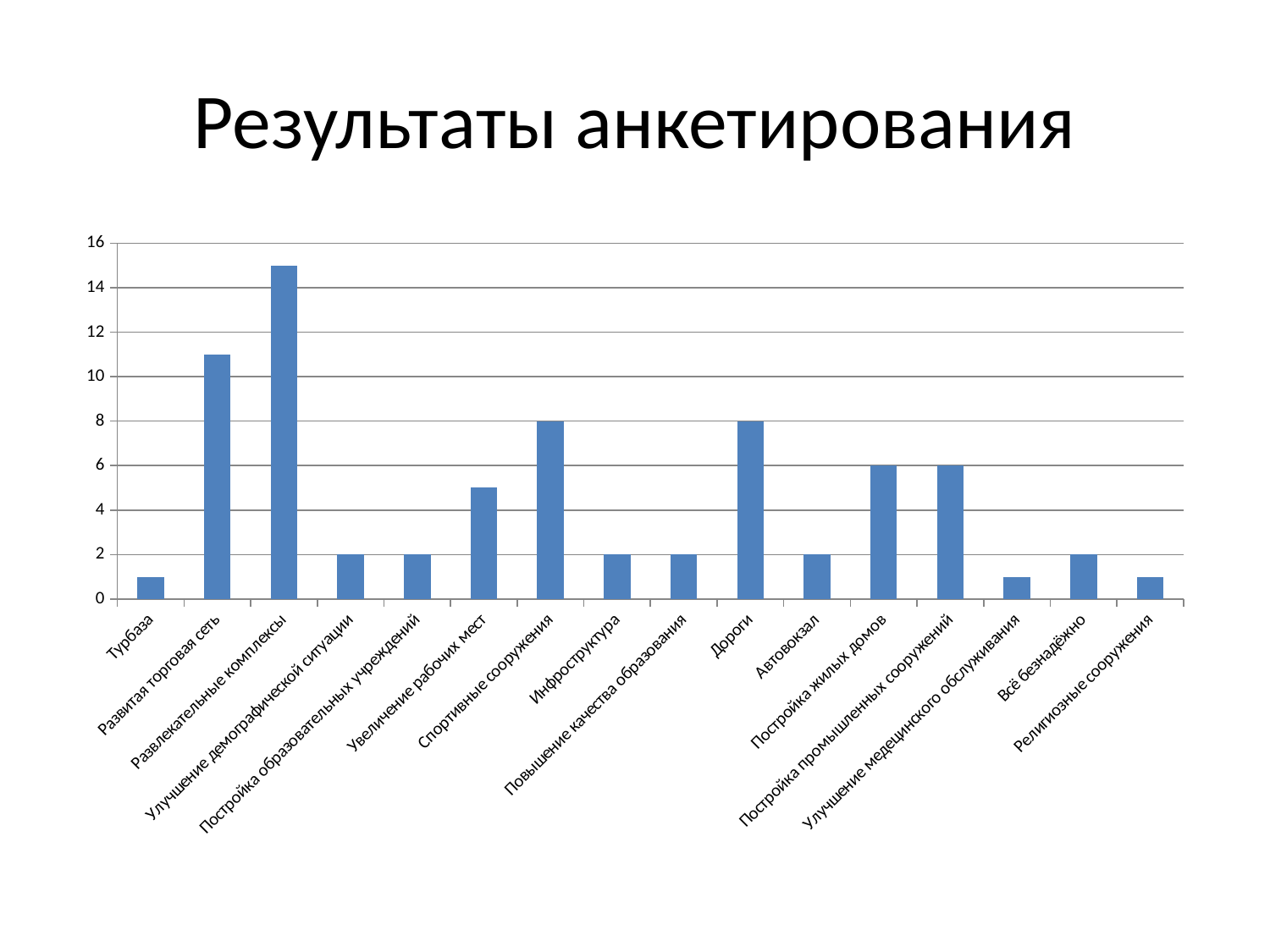
What is the difference between the values for Спортивные сооружения and Постройка промышленных сооружений? 2 Which is larger, the value for Дороги or the value for Автовокзал? Дороги What is the title of the slide? Результаты анкетирования Is the value for Увеличение рабочих мест greater or less than 6? less What kind of chart is shown on the slide? bar chart Is the value for Развитая торговая сеть greater or less than 10? greater What is the value for Дороги? 8 How many categories are plotted on the chart? 16 What is the value for Спортивные сооружения? 8 What is the value for Постройка жилых домов? 6 What is the value for Автовокзал? 2 Which category has the highest value? Развлекательные комплексы